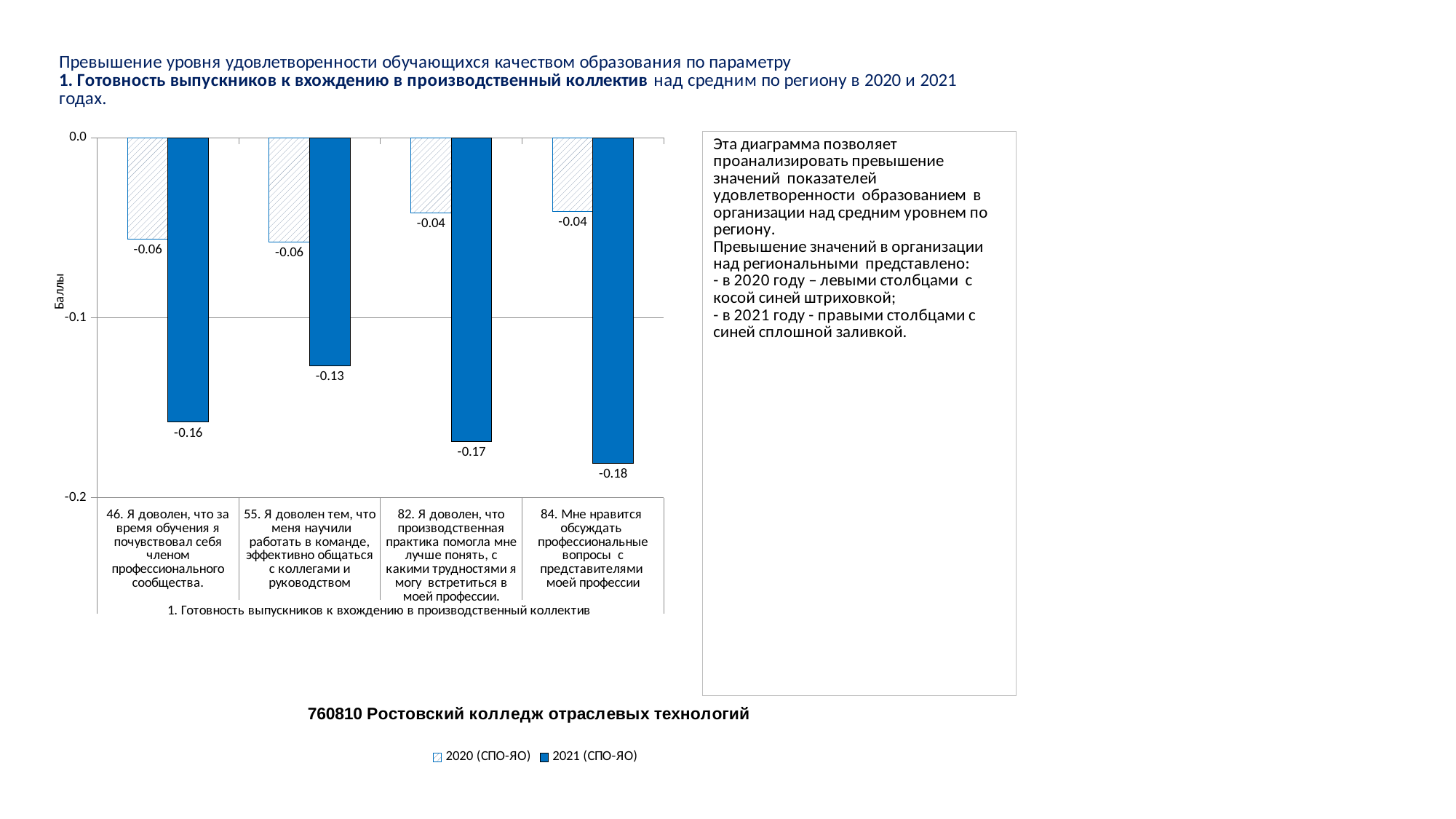
What kind of chart is shown on the slide? Bar chart Which category has the lowest value in the 2021 (СПО-ЯО) series? 84. Мне нравится обсуждать профессиональные вопросы с представителями моей профессии Which is larger: the 2021 (СПО-ЯО) value for category 55 or for category 82? Category 55 Which category has the highest value in the 2021 (СПО-ЯО) series? 55. Я доволен тем, что меня научили работать в команде, эффективно общаться с коллегами и руководством What is the value of the 2021 (СПО-ЯО) series for category 46 (Я доволен, что за время обучения я почувствовал себя членом профессионального сообщества)? -0.16 What is the label of the vertical axis of the chart? Баллы What is the value of the 2021 (СПО-ЯО) series for category 55 (Я доволен тем, что меня научили работать в команде...)? -0.13 What is the difference between the 2020 (СПО-ЯО) and 2021 (СПО-ЯО) values for category 55? 0.07 Is the 2021 (СПО-ЯО) value for category 82 greater or less than -0.1? less How many series does the chart legend list? 2 What is the value of the 2020 (СПО-ЯО) series for category 82 (Я доволен, что производственная практика помогла мне лучше понять...)? -0.04 How many categories are shown on the x axis of the chart? 4